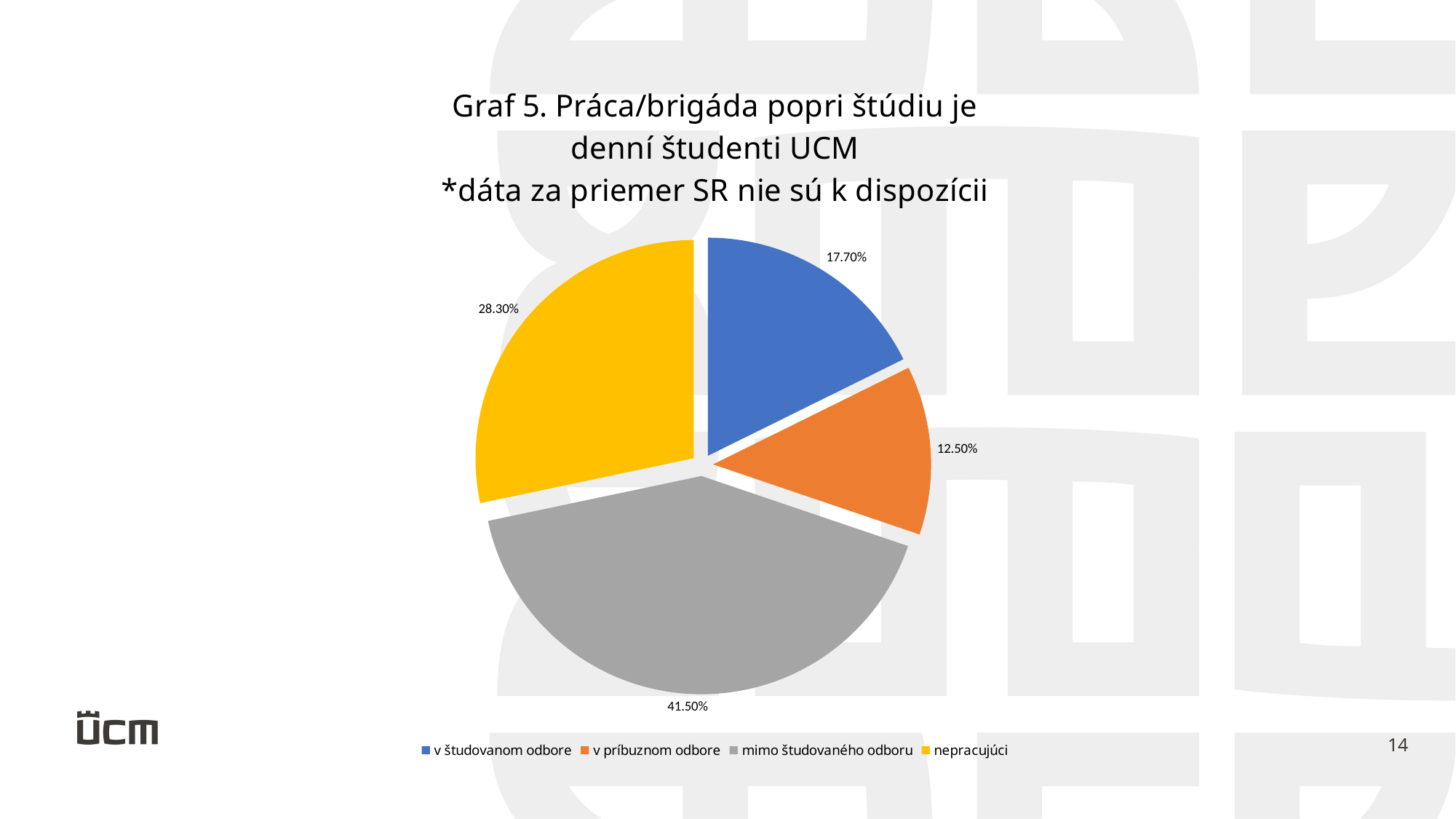
What is the value for 'mimo študovaného odboru'? 41.50% What is the value for 'v príbuznom odbore'? 12.50% Which category has the largest share of the pie? mimo študovaného odboru What is the difference between the values for 'mimo študovaného odboru' and 'nepracujúci'? 13.20% What is the title of the chart? Graf 5. Práca/brigáda popri štúdiu je denní študenti UCM *dáta za priemer SR nie sú k dispozícii How many categories does the pie chart show? 4 What is the value for 'v študovanom odbore'? 17.70% What type of chart is shown on the slide? pie chart Which is larger: 'v študovanom odbore' or 'v príbuznom odbore'? v študovanom odbore Which category has the smallest share of the pie? v príbuznom odbore What is the value for 'nepracujúci'? 28.30% Which colour represents 'nepracujúci' in the chart? yellow